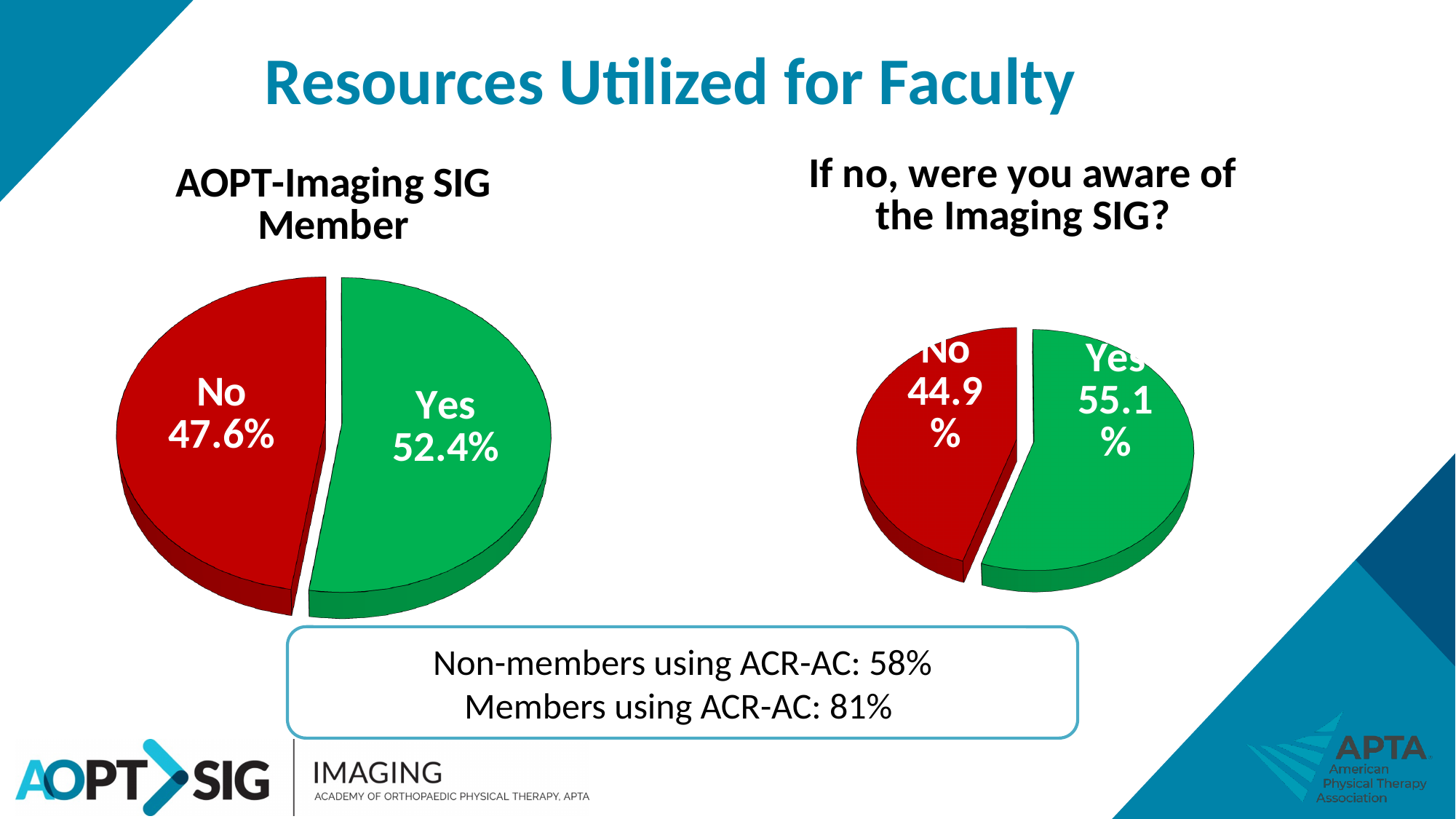
In the 'If no, were you aware of the Imaging SIG?' chart, what percentage answered Yes? 55.1% In the 'AOPT-Imaging SIG Member' chart, which slice is larger, Yes or No? Yes How many slices does the 'If no, were you aware of the Imaging SIG?' chart have? 2 In the 'AOPT-Imaging SIG Member' chart, what percentage answered Yes? 52.4% In the 'If no, were you aware of the Imaging SIG?' chart, which slice is the smallest? No What is the title of the chart on the left of the slide? AOPT-Imaging SIG Member In the 'AOPT-Imaging SIG Member' chart, what colour is the No slice? Red In the 'If no, were you aware of the Imaging SIG?' chart, what percentage answered No? 44.9% In the 'AOPT-Imaging SIG Member' chart, what percentage answered No? 47.6% In the 'AOPT-Imaging SIG Member' chart, what is the difference between the Yes and No percentages? 4.8% What type of chart is used for 'AOPT-Imaging SIG Member'? Pie chart In the 'If no, were you aware of the Imaging SIG?' chart, what is the difference between the Yes and No percentages? 10.2%